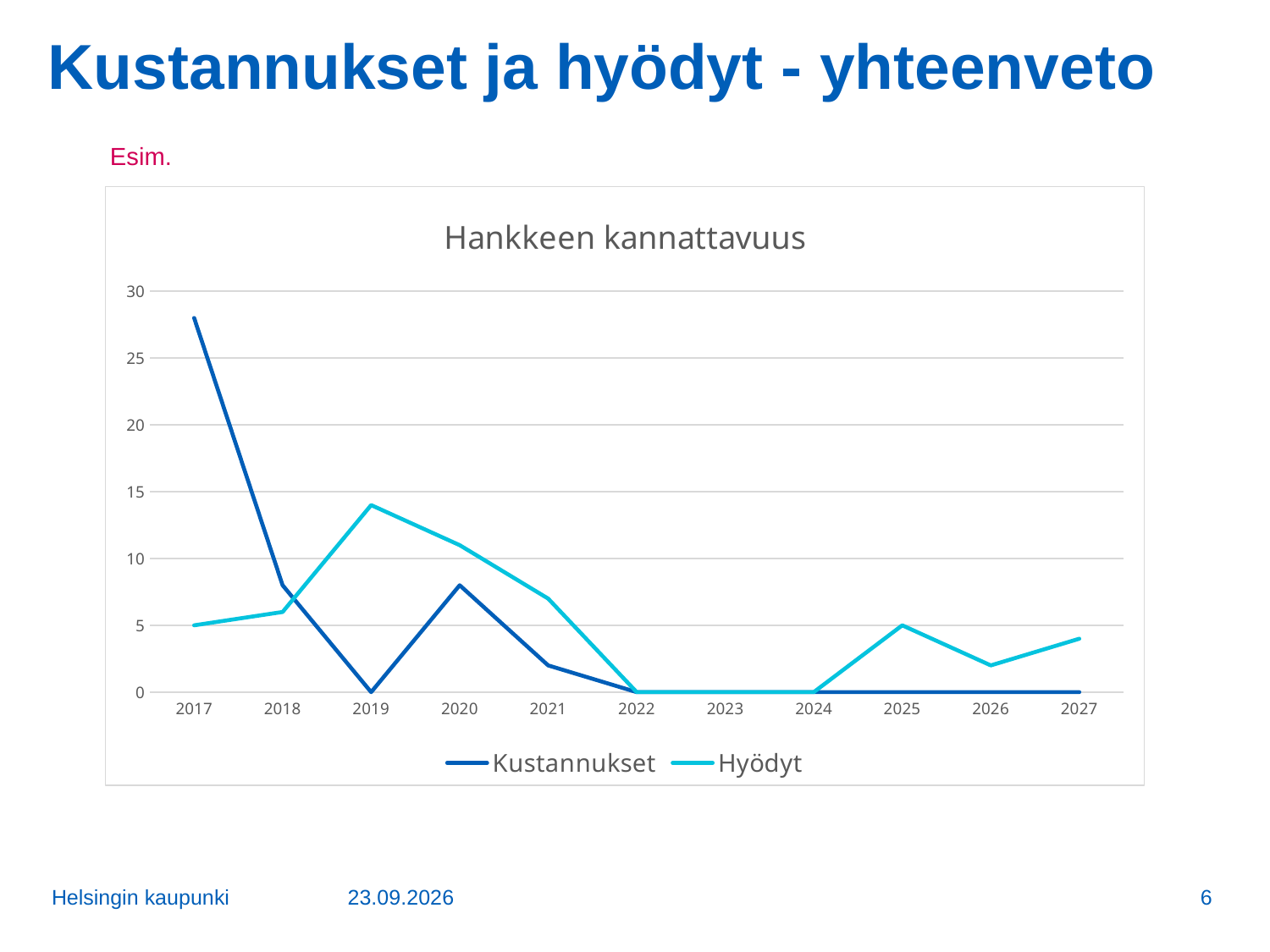
In which year is Hyödyt highest? 2019 What is the value of Hyödyt in 2025? 5 What is the value of Hyödyt in 2023? 0 How many series does the legend list? 2 Which is larger in 2019, Kustannukset or Hyödyt? Hyödyt What type of chart is shown on the slide? line chart In which year is Kustannukset highest? 2017 Does Kustannukset rise or fall from 2017 to 2019? fall Is the value for Kustannukset in 2017 greater or less than 25? greater What is the title of the chart? Hankkeen kannattavuus How many years are shown on the x axis? 11 What is the value of Kustannukset in 2019? 0